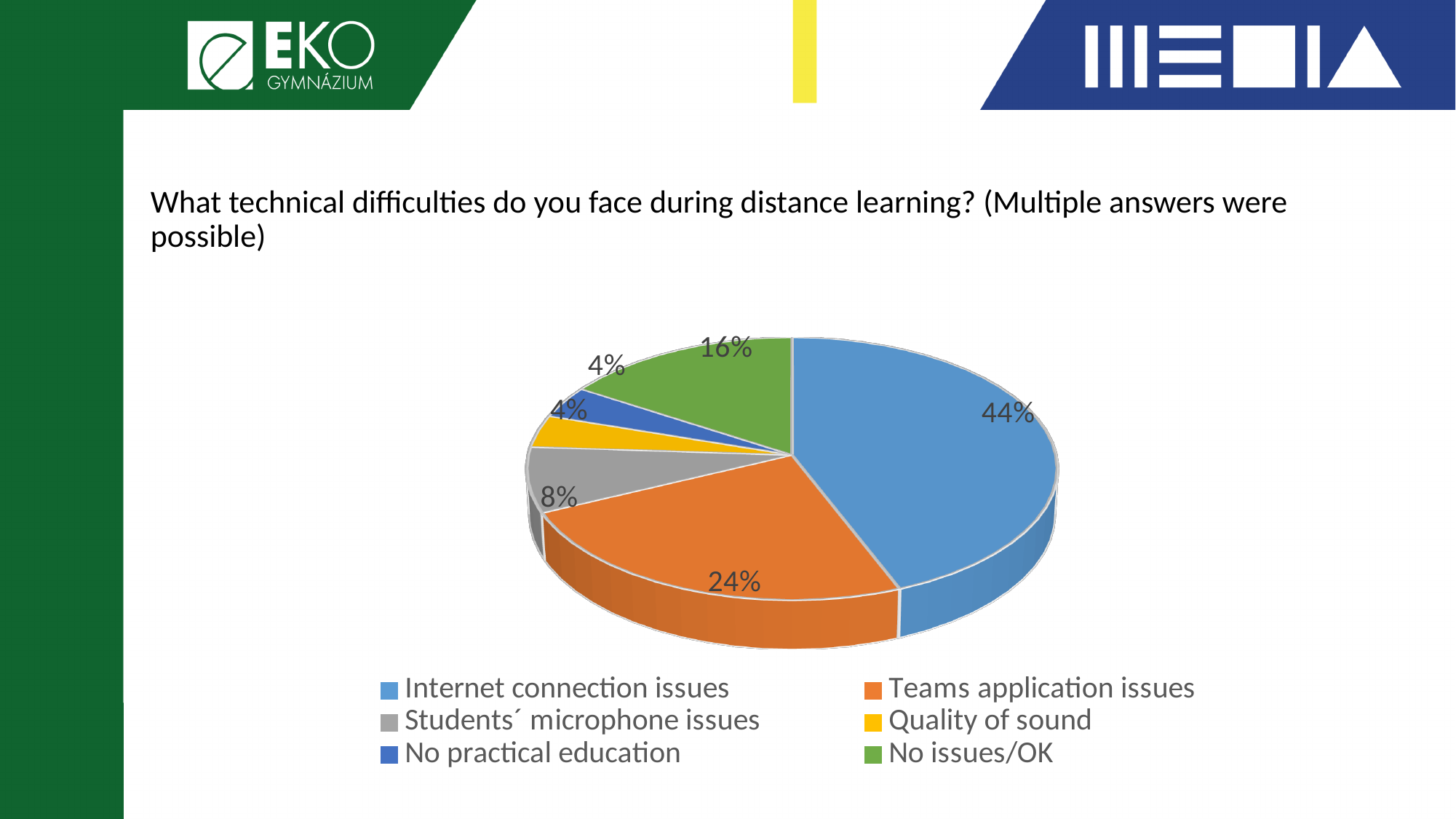
What percentage of the pie is Students´ microphone issues? 8% What is the difference in percentage points between Internet connection issues and Teams application issues? 20 What question is the chart answering, according to the slide title? What technical difficulties do you face during distance learning? (Multiple answers were possible) What kind of chart is shown on the slide? pie chart Which category has the largest share of the pie? Internet connection issues What percentage of the pie is Internet connection issues? 44% What percentage of the pie is Teams application issues? 24% What percentage of the pie is Quality of sound? 4% Which is larger, the share for No issues/OK or the share for Students´ microphone issues? No issues/OK What percentage of the pie is No issues/OK? 16% What colour is the slice for Teams application issues? orange How many categories does the legend list? 6